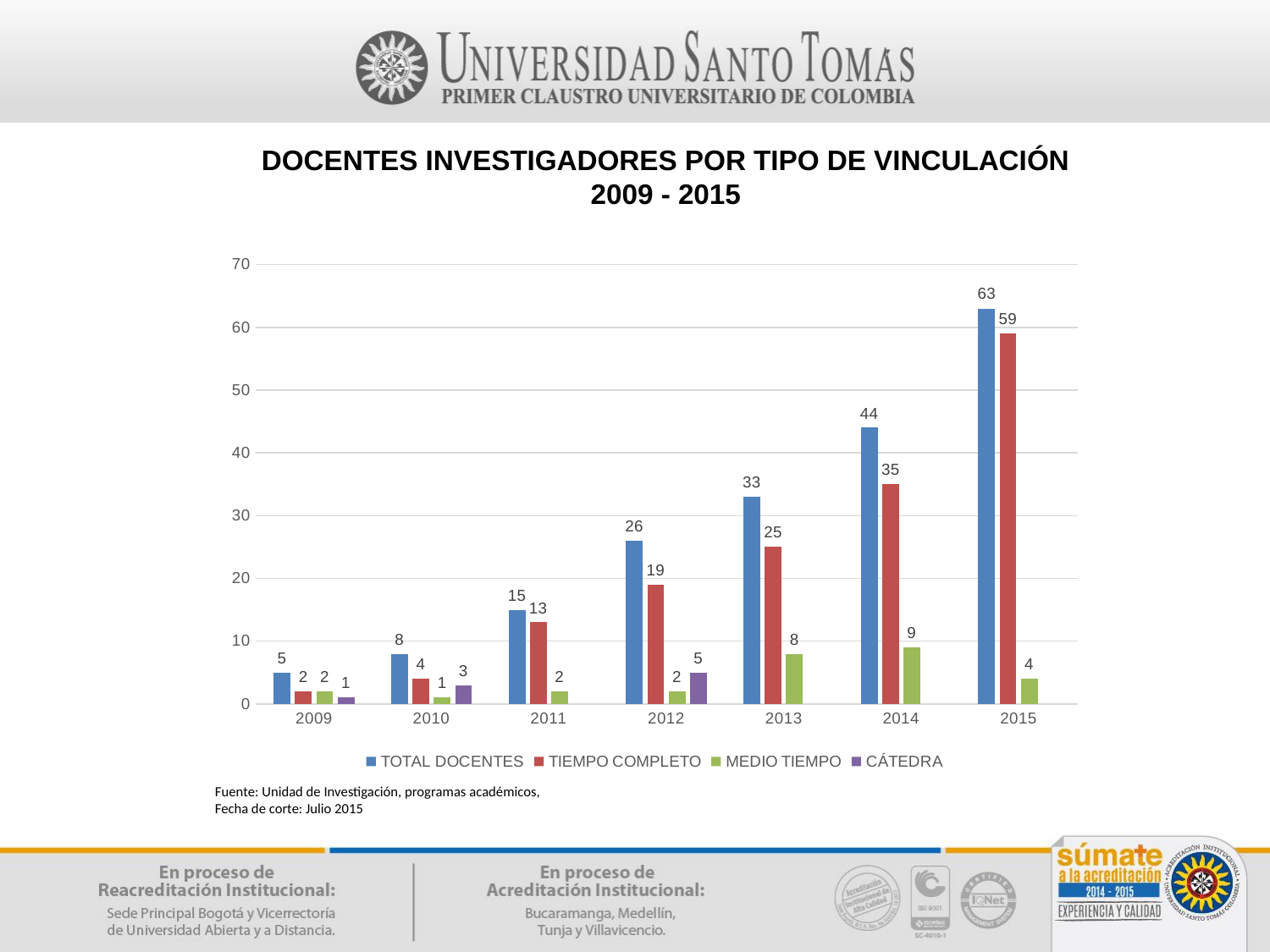
How many series does the legend list? 4 Which year has the highest value for TOTAL DOCENTES? 2015 What is the difference between TOTAL DOCENTES and TIEMPO COMPLETO in 2014? 9 Which year has the lowest value for TIEMPO COMPLETO? 2009 Does the value of TOTAL DOCENTES rise or fall from 2009 to 2015? Rise What is the value of CÁTEDRA for 2012? 5 What is the value of TOTAL DOCENTES for 2015? 63 What kind of chart is shown on the slide? Bar chart What is the value of TIEMPO COMPLETO for 2013? 25 How many years are shown on the x axis? 7 What is the value of MEDIO TIEMPO for 2014? 9 Which is larger in 2011: TIEMPO COMPLETO or MEDIO TIEMPO? TIEMPO COMPLETO